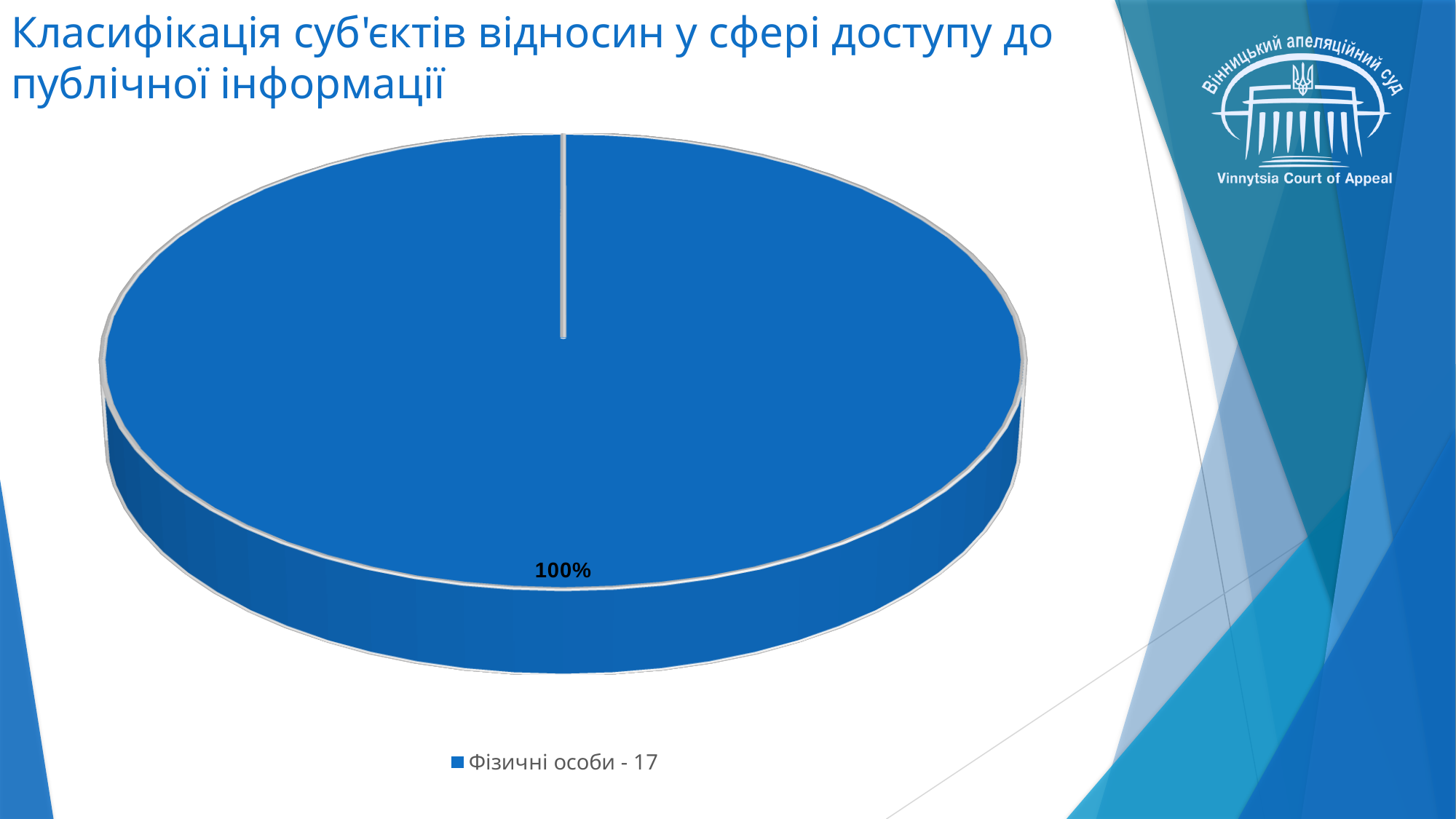
What is the legend entry for the pie chart? Фізичні особи - 17 What colour is the slice for "Фізичні особи - 17"? blue How many slices does the pie chart have? 1 What percentage label is printed on the pie chart? 100% How many entries does the legend list? 1 What kind of chart is shown on the slide? pie chart What share of the pie does the slice labelled "Фізичні особи - 17" represent? 100%